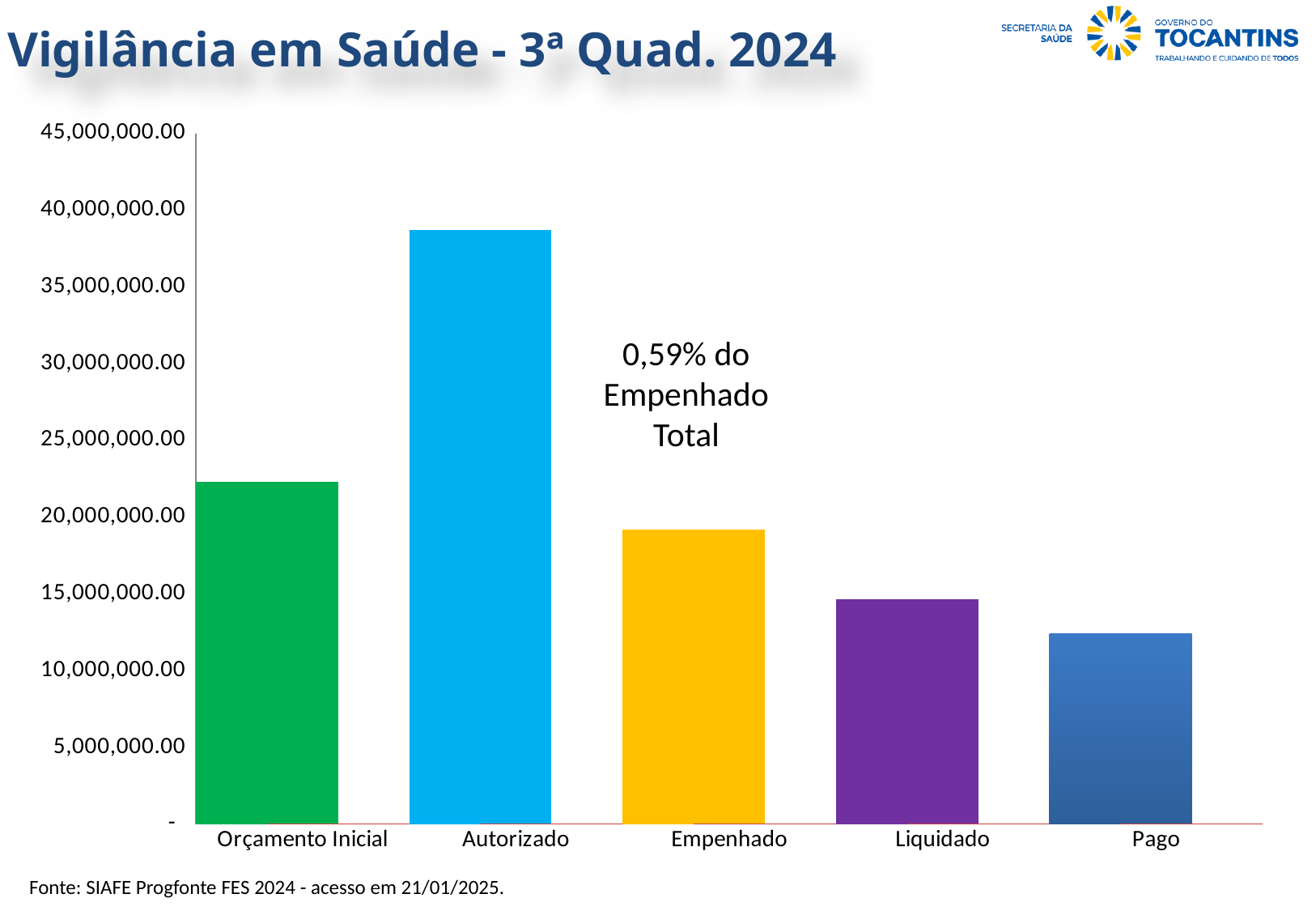
How many categories are shown on the x axis? 5 Is the value for Pago greater or less than 10,000,000.00? greater Which category has the lowest bar? Pago Which is larger, the value for Orçamento Inicial or the value for Empenhado? Orçamento Inicial Which is larger, the value for Liquidado or the value for Pago? Liquidado What is the title of the chart on the slide? Vigilância em Saúde - 3ª Quad. 2024 What kind of chart is shown on the slide? bar chart Is the value for Autorizado greater or less than 35,000,000.00? greater Is the value for Orçamento Inicial greater or less than 25,000,000.00? less Which category has the highest bar? Autorizado Do the values rise or fall from Autorizado to Pago along the x axis? fall